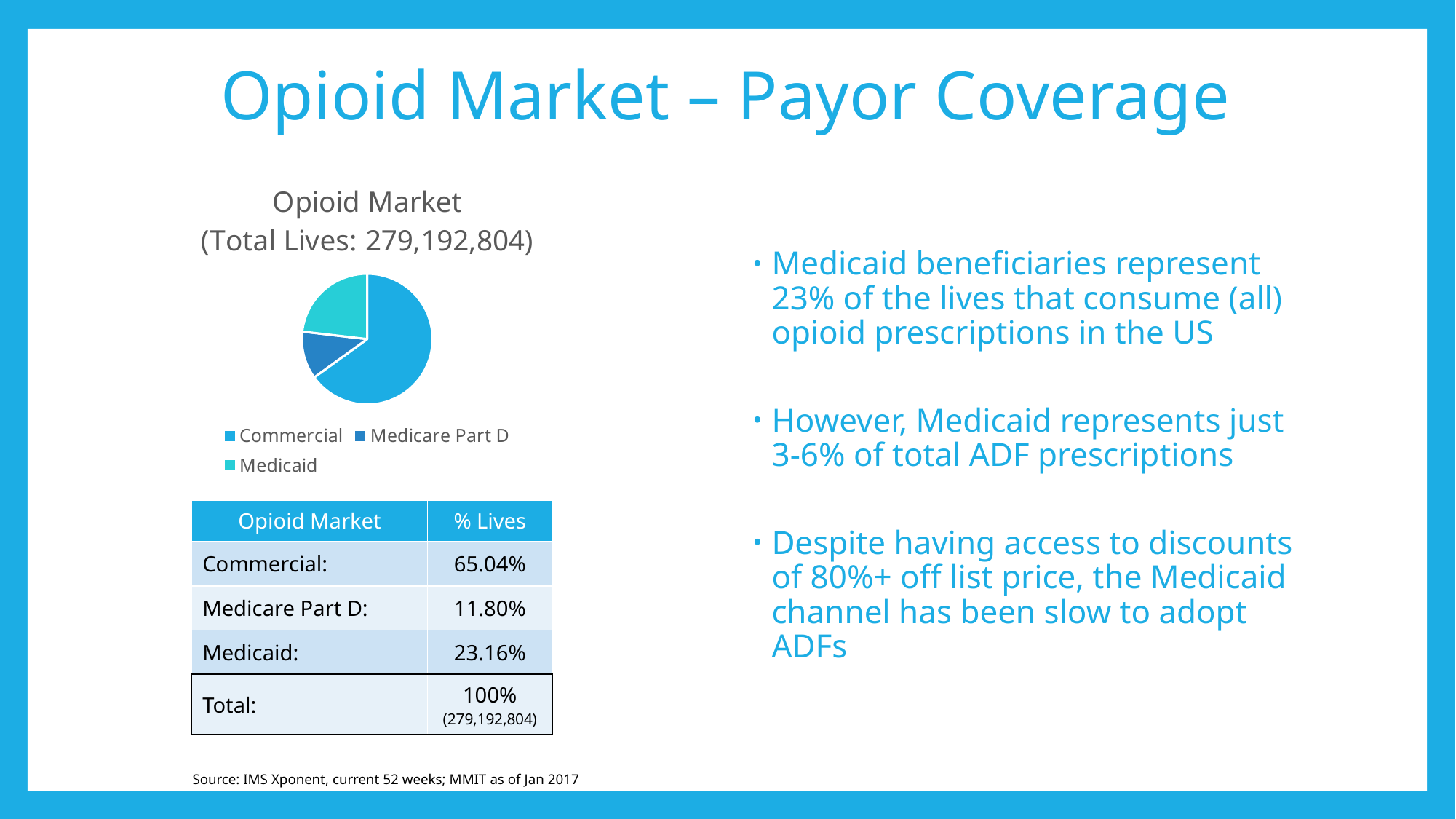
What share of lives does the Commercial slice represent? 65.04% What kind of chart is shown on the slide? pie chart Which legend entry is shown in the lightest teal colour? Medicaid How many entries does the pie chart's legend list? 3 What is the difference in percentage points between the Commercial and Medicaid shares? 41.88% Which category has the largest slice of the pie chart? Commercial What share of lives does the Medicare Part D slice represent? 11.80% What share of lives does the Medicaid slice represent? 23.16% Which category has the smallest slice of the pie chart? Medicare Part D Which is larger, the Medicaid slice or the Medicare Part D slice? Medicaid What is the total number of lives stated in the pie chart's title? 279,192,804 How many slices does the pie chart have? 3